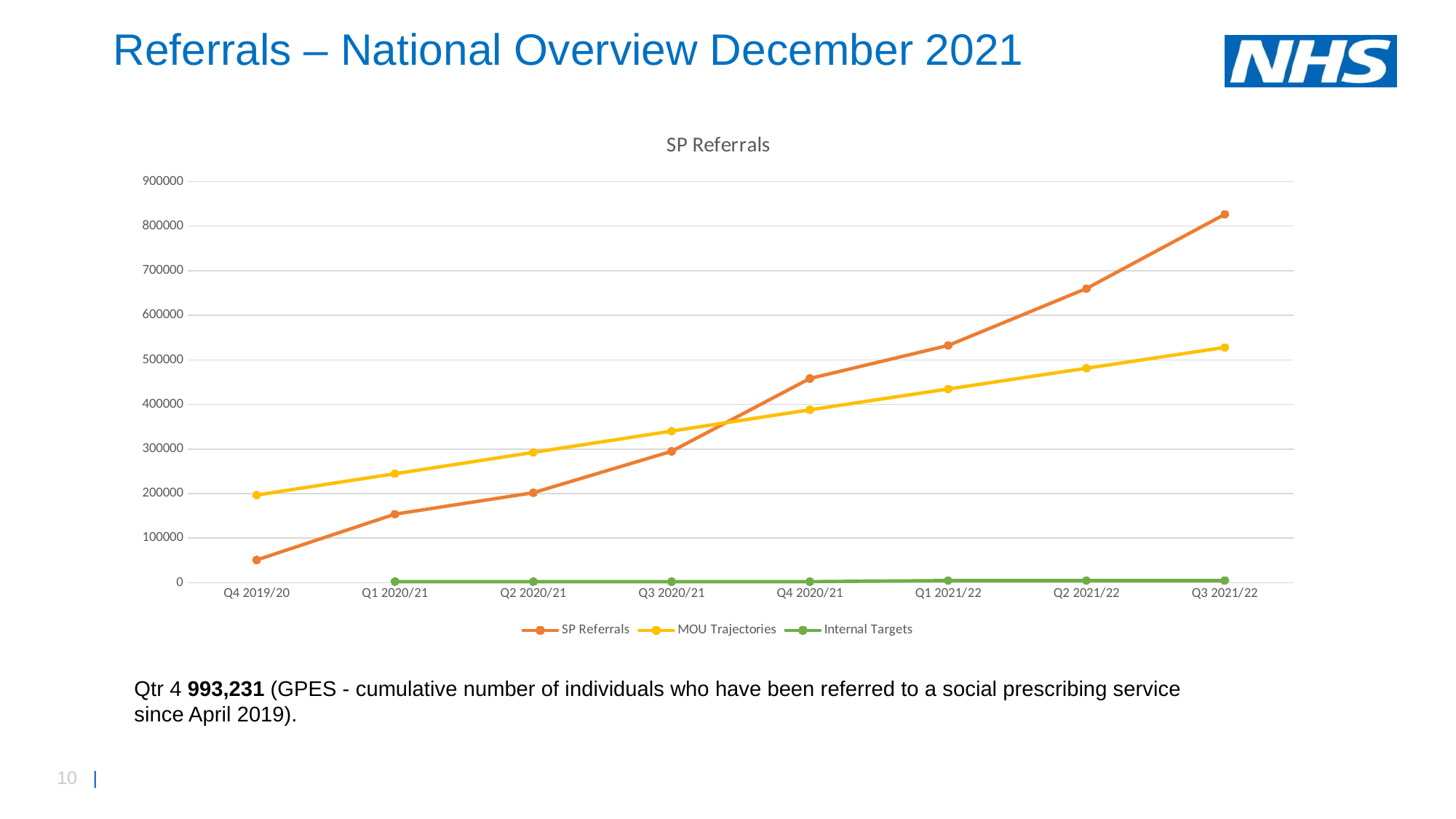
What kind of chart is shown on the slide? Line chart How many series does the legend of the SP Referrals chart list? 3 Is the SP Referrals value for Q4 2019/20 greater or less than 100000? less At Q2 2021/22, which is larger: SP Referrals or MOU Trajectories? SP Referrals Which series is shown in green in the chart? Internal Targets Is the SP Referrals value for Q3 2021/22 greater or less than 800000? greater In which quarter is the SP Referrals series at its lowest? Q4 2019/20 Do the SP Referrals values rise or fall from Q4 2019/20 to Q3 2021/22? Rise How many quarters are plotted along the x axis of the SP Referrals chart? 8 In which quarter is the SP Referrals series at its highest? Q3 2021/22 At Q1 2020/21, which is larger: SP Referrals or MOU Trajectories? MOU Trajectories What is the title of the chart? SP Referrals